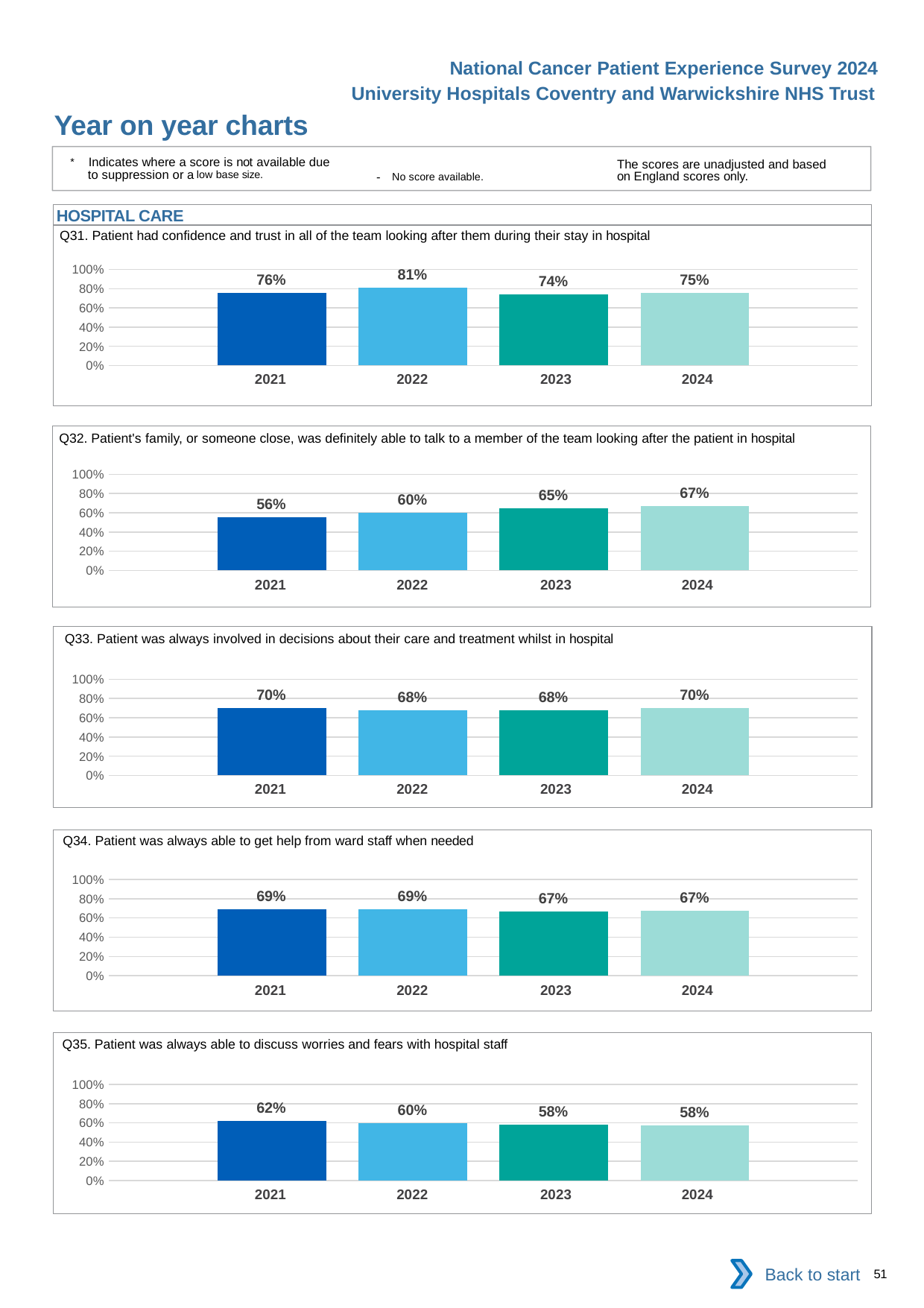
In the Q33 chart, what is the value for 2023? 68% In the Q31 chart, what is the value for 2022? 81% In the Q34 chart, which is larger, the value for 2021 or the value for 2024? 2021 In the Q34 chart, what is the difference between the 2022 value and the 2023 value? 2% In the Q32 chart, what is the value for 2024? 67% What type of chart is used for Q31? bar chart In the Q35 chart, what is the value for 2022? 60% In the Q35 chart, which year has the highest value? 2021 In the Q32 chart, do the values rise or fall from 2021 to 2024? rise In the Q32 chart, what is the difference between the 2024 value and the 2021 value? 11% How many years are shown on the x axis of the Q33 chart? 4 In the Q31 chart, which year has the lowest value? 2023